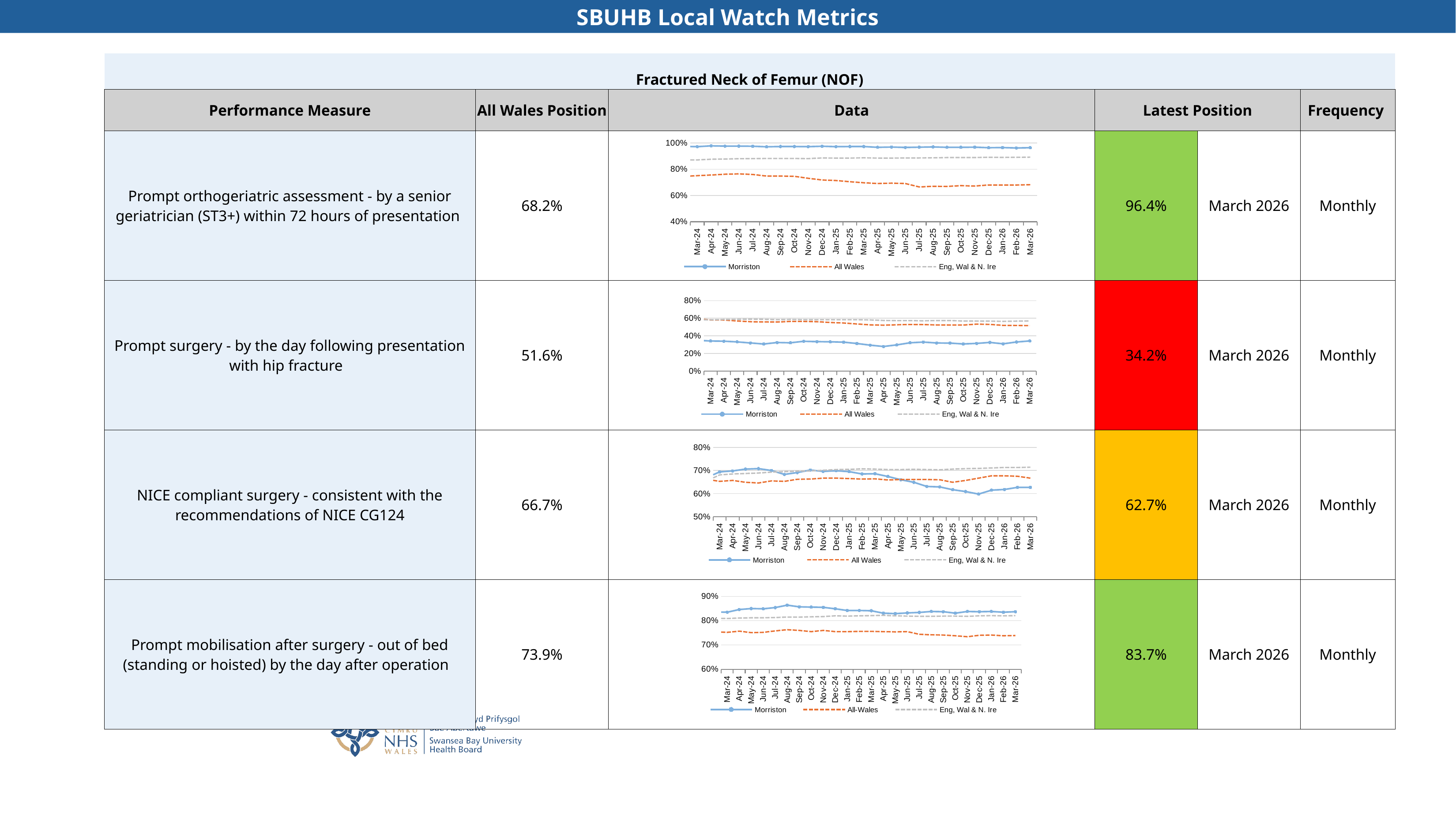
In the 'Prompt mobilisation after surgery' chart, is the All Wales value for Mar-26 greater or less than 80%? less In the 'Prompt orthogeriatric assessment' chart, is the All Wales value for Mar-26 greater or less than 80%? less In the 'Prompt orthogeriatric assessment' chart, how many monthly points are plotted along the x axis? 25 In the 'Prompt orthogeriatric assessment' chart, is the Morriston value for Mar-26 greater or less than 80%? greater In the 'NICE compliant surgery' chart, does the Morriston line overall rise or fall from Mar-24 to Mar-26? fall What are the three legend entries in the 'Prompt orthogeriatric assessment' chart? Morriston, All Wales, Eng, Wal & N. Ire In the 'Prompt surgery' chart, which series is higher in Mar-26, Morriston or All Wales? All Wales What kind of chart is shown in the Data column for the 'Prompt orthogeriatric assessment' row? Line chart How many series does the legend list in the 'Prompt surgery' chart? 3 In the 'Prompt mobilisation after surgery' chart, which series is higher in Mar-26, Morriston or All Wales? Morriston